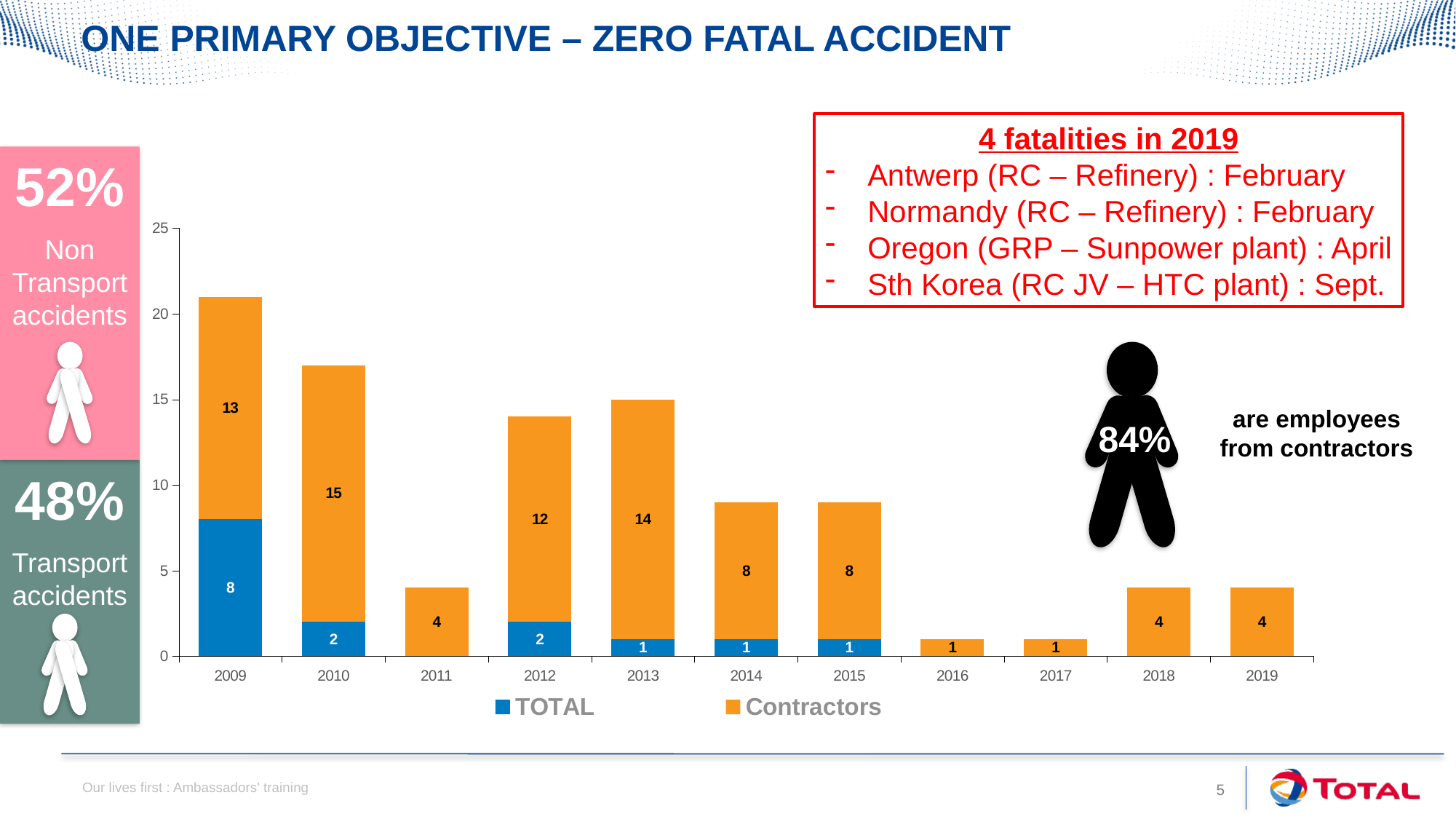
What is the TOTAL value for 2009? 8 What is the difference between the Contractors values for 2013 and 2014? 6 What type of chart is shown on the slide? Stacked bar chart Which colour represents the Contractors series in the chart? Orange Which is larger, the Contractors value for 2011 or for 2016? 2011 What is the total of the stacked bar for 2009? 21 What is the Contractors value for 2010? 15 How many years are shown on the x axis of the chart? 11 Which year has the highest Contractors value? 2010 What is the Contractors value for 2019? 4 How many series does the chart legend list? 2 What is the total of the stacked bar for 2012? 14